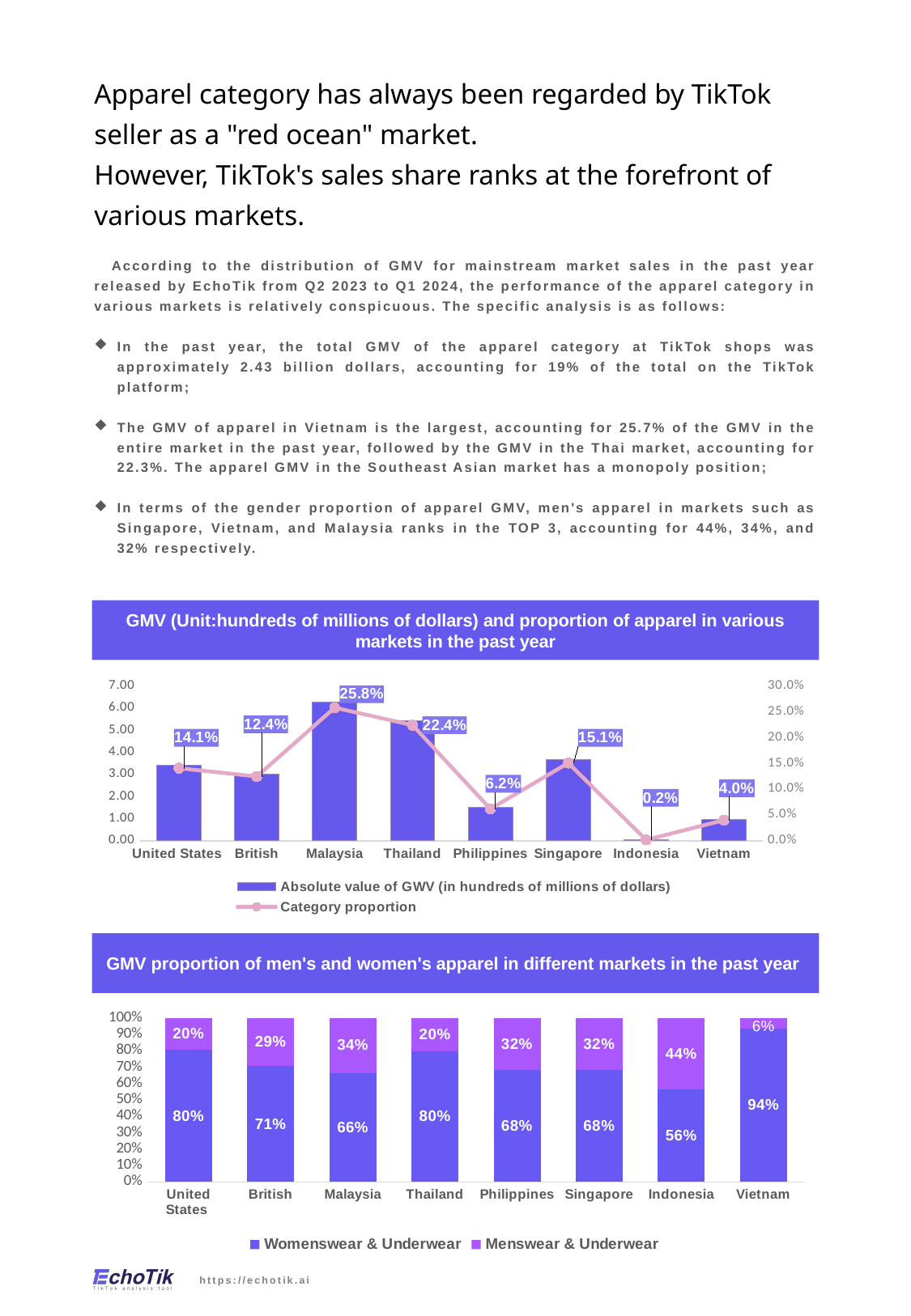
In the top chart (GMV and proportion of apparel), what is the difference between the category proportion of Malaysia and that of Thailand? 3.4 percentage points In the top chart (GMV and proportion of apparel), how many markets are shown on the x axis? 8 In the top chart (GMV and proportion of apparel), is the absolute value of GMV bar for Malaysia greater or less than 5.00? greater In the bottom chart (GMV proportion of men's and women's apparel), which market has the highest Womenswear & Underwear share? Vietnam In the top chart (GMV and proportion of apparel), which market has the highest category proportion? Malaysia What kind of chart is the bottom chart (GMV proportion of men's and women's apparel)? Stacked bar chart In the top chart (GMV and proportion of apparel), what is the category proportion for Thailand? 22.4% In the top chart (GMV and proportion of apparel), which market has the lowest category proportion? Indonesia In the bottom chart (GMV proportion of men's and women's apparel), which has the larger Menswear & Underwear share, Malaysia or British? Malaysia In the top chart (GMV and proportion of apparel), how many series does the legend list? 2 In the chart titled "GMV proportion of men's and women's apparel in different markets in the past year", what is the Menswear & Underwear share for Indonesia? 44% In the chart titled "GMV (Unit:hundreds of millions of dollars) and proportion of apparel in various markets in the past year", what is the category proportion for Malaysia? 25.8%